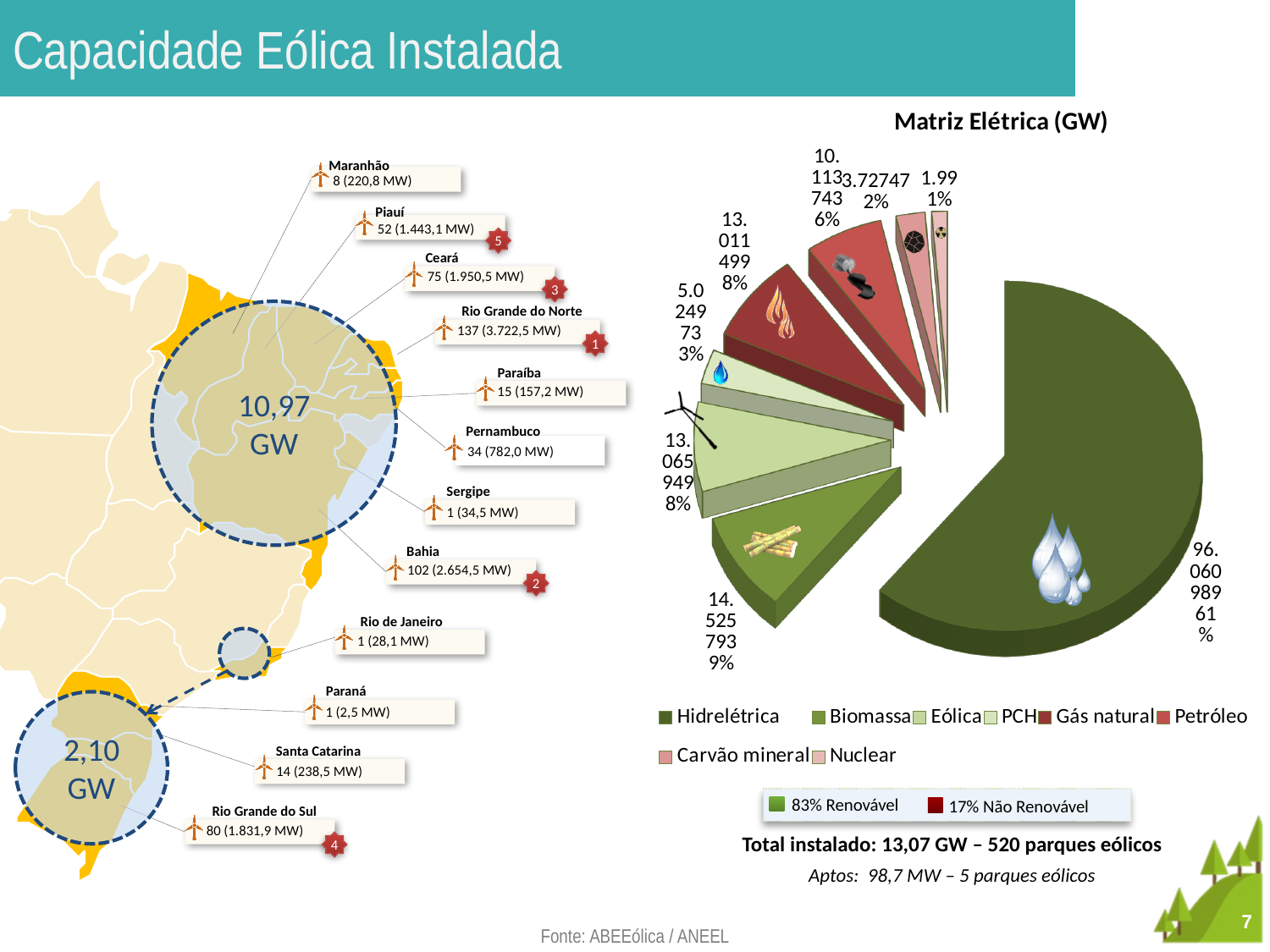
In the 'Matriz Elétrica (GW)' pie chart, which has a larger share, Biomassa or Petróleo? Biomassa In the 'Matriz Elétrica (GW)' pie chart, what share does Hidrelétrica have? 61% How many entries does the legend of the 'Matriz Elétrica (GW)' pie chart list? 8 In the 'Matriz Elétrica (GW)' pie chart, which source has the smallest slice? Nuclear In the 'Matriz Elétrica (GW)' pie chart, how many percentage points larger is the Hidrelétrica share than the Biomassa share? 52 In the 'Matriz Elétrica (GW)' pie chart, what is the value shown for Nuclear? 1.99 In the 'Matriz Elétrica (GW)' pie chart, what share does Eólica have? 8% What kind of chart is the 'Matriz Elétrica (GW)' chart? pie chart In the 'Matriz Elétrica (GW)' pie chart, which source has the largest slice? Hidrelétrica In the 'Matriz Elétrica (GW)' pie chart, what share does Petróleo have? 6% What is the title of the pie chart on the slide? Matriz Elétrica (GW)